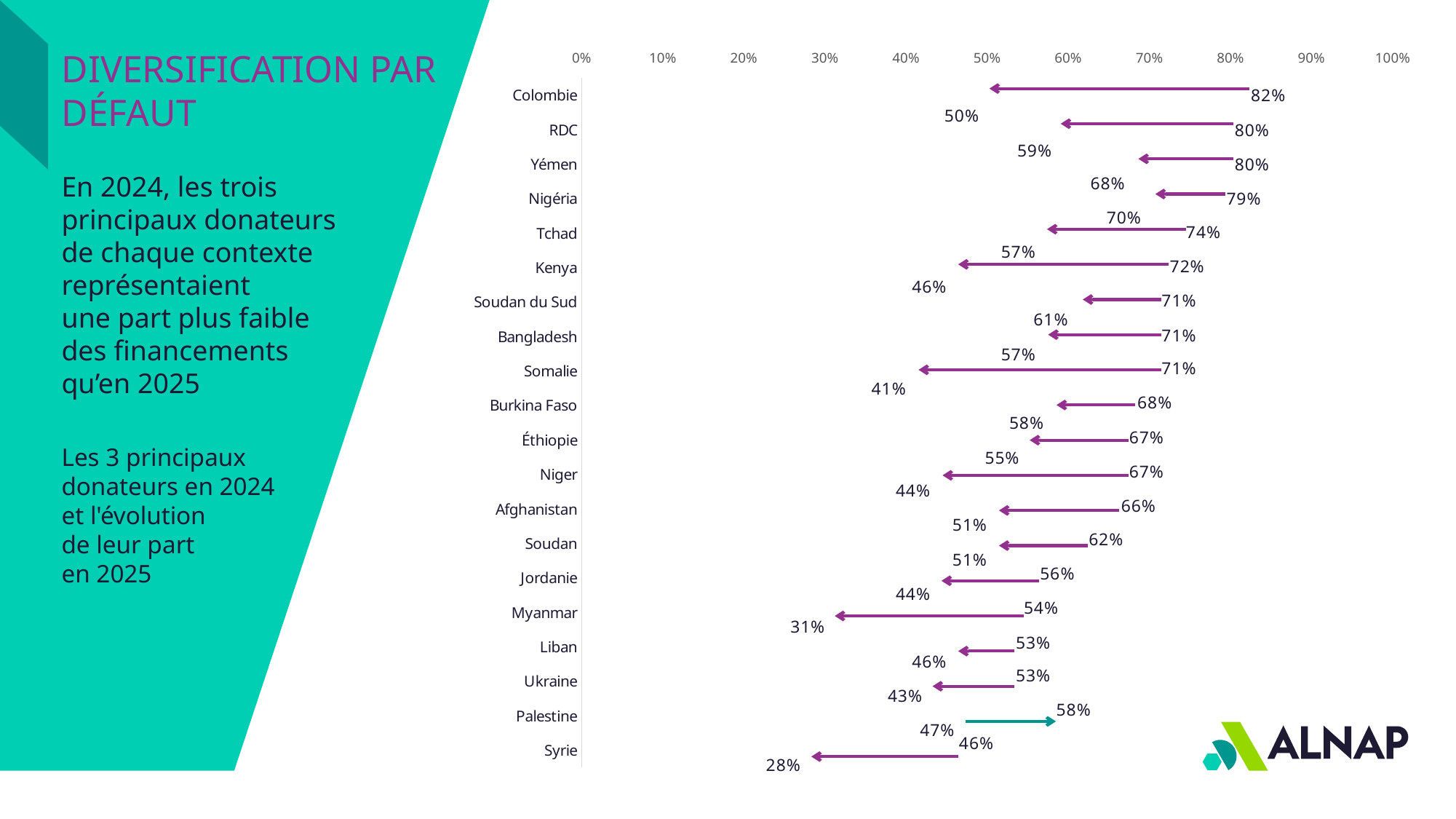
What is the 2024 share for Tchad? 74% How many contexts are listed on the chart? 20 Which is larger: the 2025 share for Kenya or the 2025 share for Soudan du Sud? Soudan du Sud By how many percentage points did the share for Myanmar fall from 2024 to 2025? 23 percentage points What colour is the arrow for Palestine, which differs from the others? Teal Which context has the highest 2024 share of the three main donors? Colombie Which context is the only one whose share of the three main donors increased from 2024 to 2025? Palestine What is the 2024 share of the three main donors for Colombie? 82% What is the 2025 share of the three main donors for Syrie? 28% What is the difference between the 2024 and 2025 values for Somalie? 30 percentage points What is the 2025 value shown for Palestine? 58% Which context has the lowest 2025 share of the three main donors? Syrie